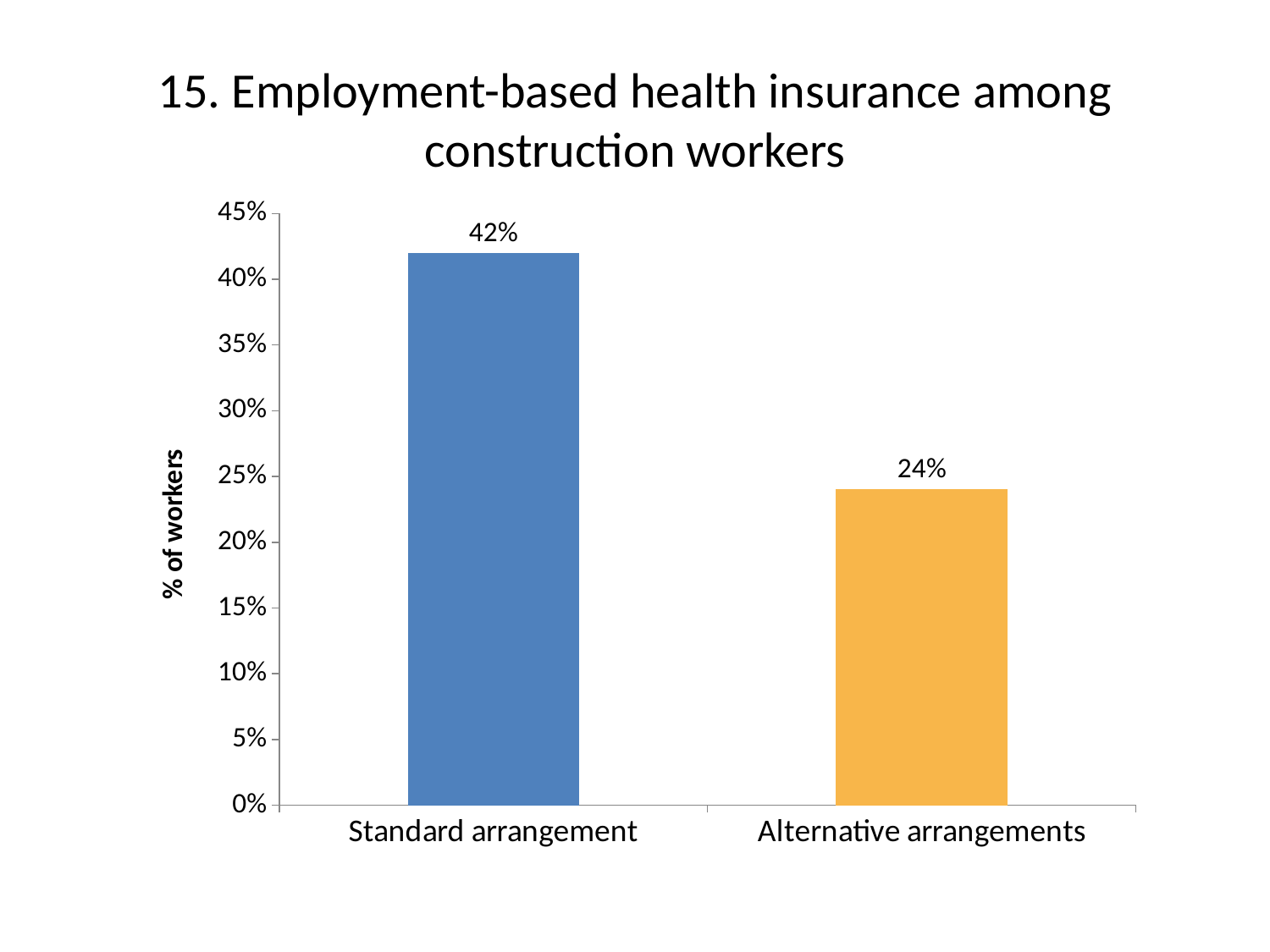
Is the value for standard arrangement larger or smaller than the value for alternative arrangements? larger What percentage of workers with a standard arrangement have employment-based health insurance? 42% What is the label of the vertical axis? % of workers What is the title of the chart? 15. Employment-based health insurance among construction workers What is the difference in percentage points between the standard arrangement and alternative arrangements bars? 18% Which category has the higher percentage of workers with employment-based health insurance? Standard arrangement Is the value for alternative arrangements greater or less than 30%? less Is the value for standard arrangement greater or less than 40%? greater What type of chart is shown on the slide? Bar chart What percentage of workers with alternative arrangements have employment-based health insurance? 24% Which category has the lower percentage of workers with employment-based health insurance? Alternative arrangements How many categories are shown on the chart? 2